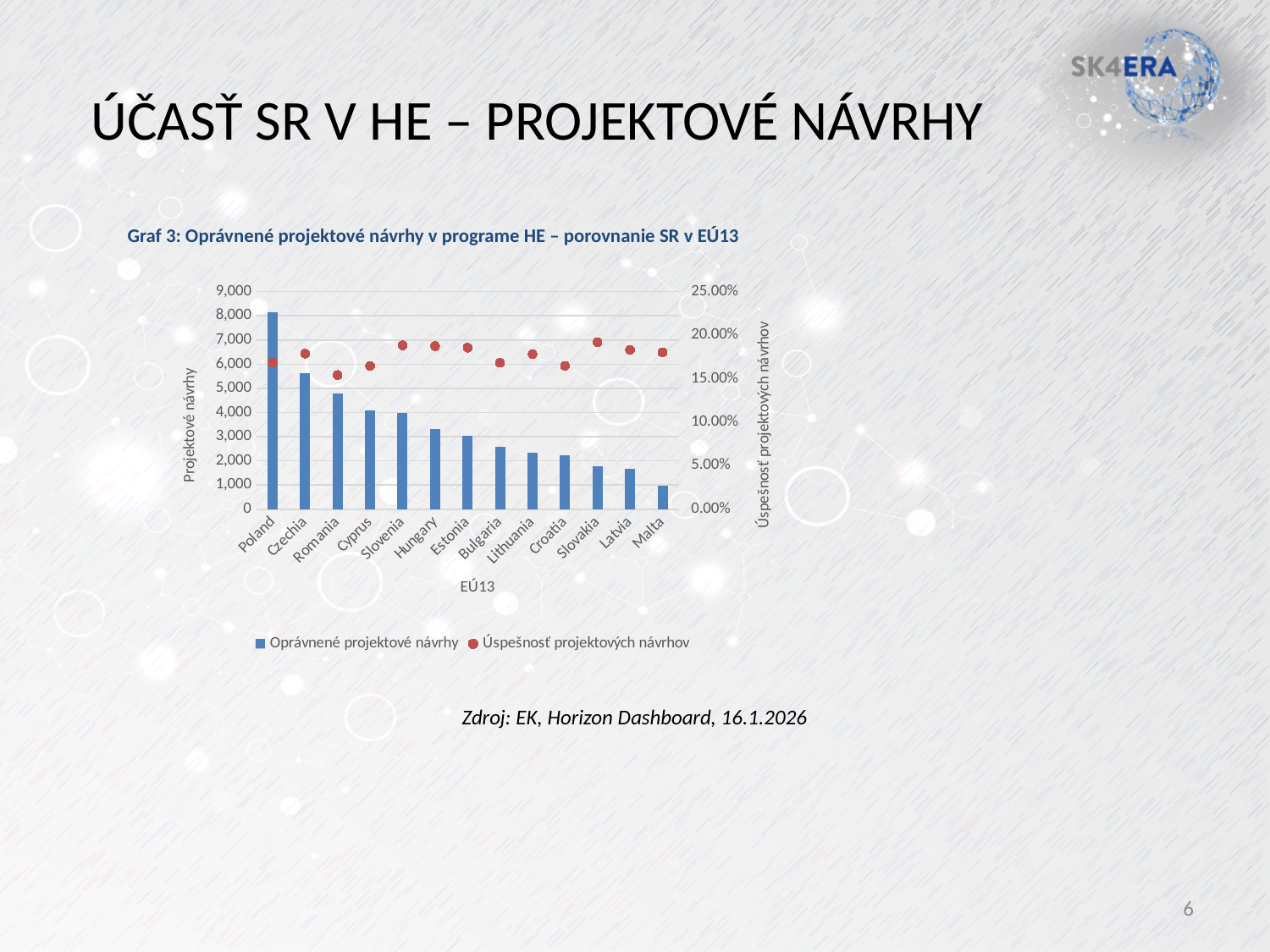
Is the Oprávnené projektové návrhy value for Czechia greater or less than 5,000? greater Which country has the highest bar for Oprávnené projektové návrhy? Poland Which country has the lowest bar for Oprávnené projektové návrhy? Malta Is the Oprávnené projektové návrhy value for Hungary greater or less than 3,000? greater What label is shown on the right-hand vertical axis of the chart? Úspešnosť projektových návrhov Do the Oprávnené projektové návrhy bars rise or fall from left to right along the x axis? fall How many series does the chart legend list? 2 What is the title of the chart? Graf 3: Oprávnené projektové návrhy v programe HE – porovnanie SR v EÚ13 Which has the larger Oprávnené projektové návrhy bar, Czechia or Romania? Czechia How many countries are shown on the x axis of the chart? 13 Is the Oprávnené projektové návrhy value for Slovakia greater or less than 2,000? less